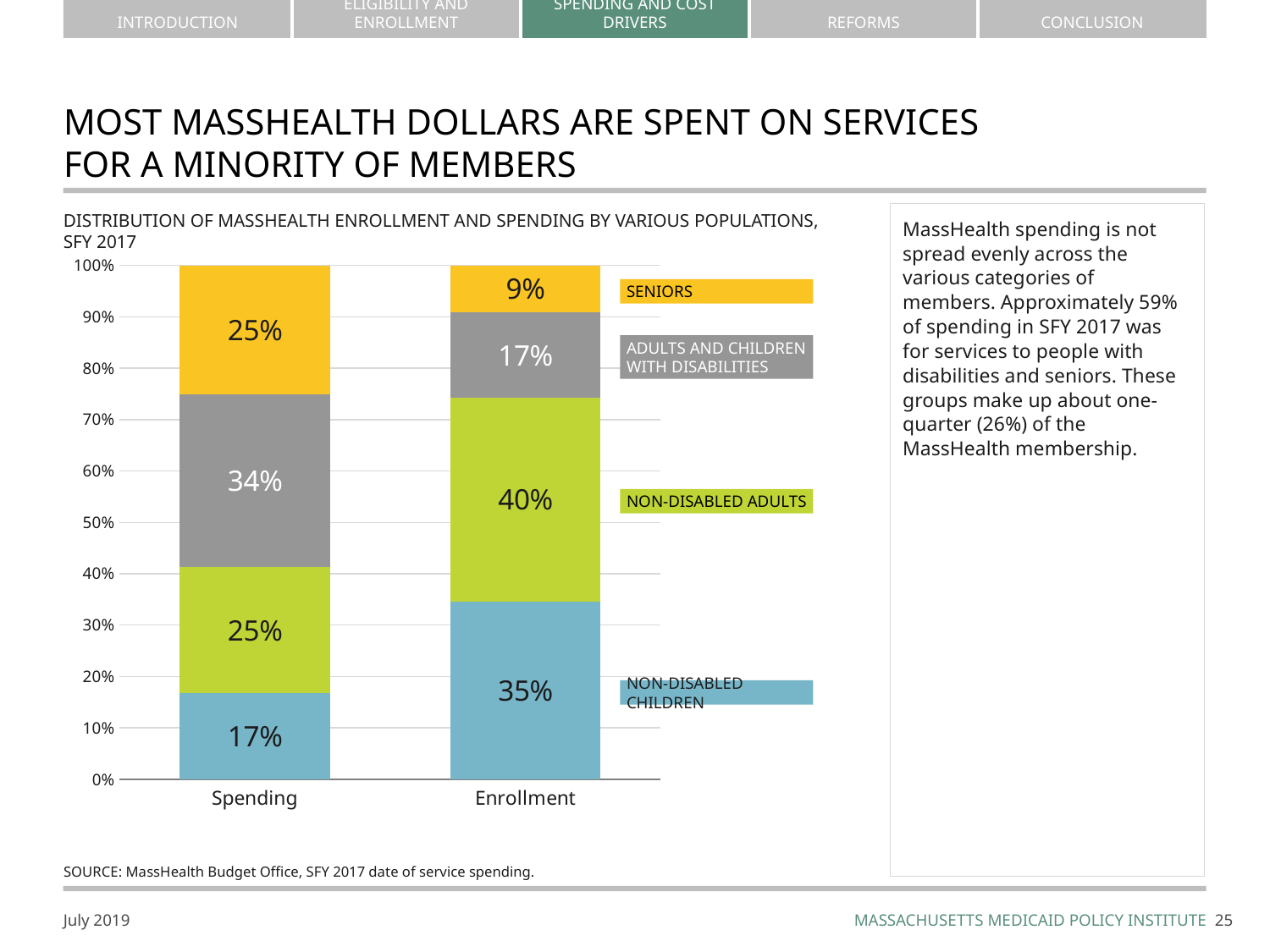
Which population has the largest share of Spending? Adults and Children with Disabilities What is the combined share of Spending for Seniors and Adults and Children with Disabilities? 59% What share of Enrollment is Non-Disabled Children? 35% How many bars are shown in the chart? 2 What share of Spending goes to Seniors? 25% Is the Seniors share larger in Spending or in Enrollment? Spending What share of Spending goes to Adults and Children with Disabilities? 34% How many populations does the legend list? 4 What kind of chart is shown? Stacked bar chart What is the difference between the Non-Disabled Adults share of Enrollment and of Spending? 15% What share of Enrollment is Seniors? 9% Which population has the smallest share of Enrollment? Seniors